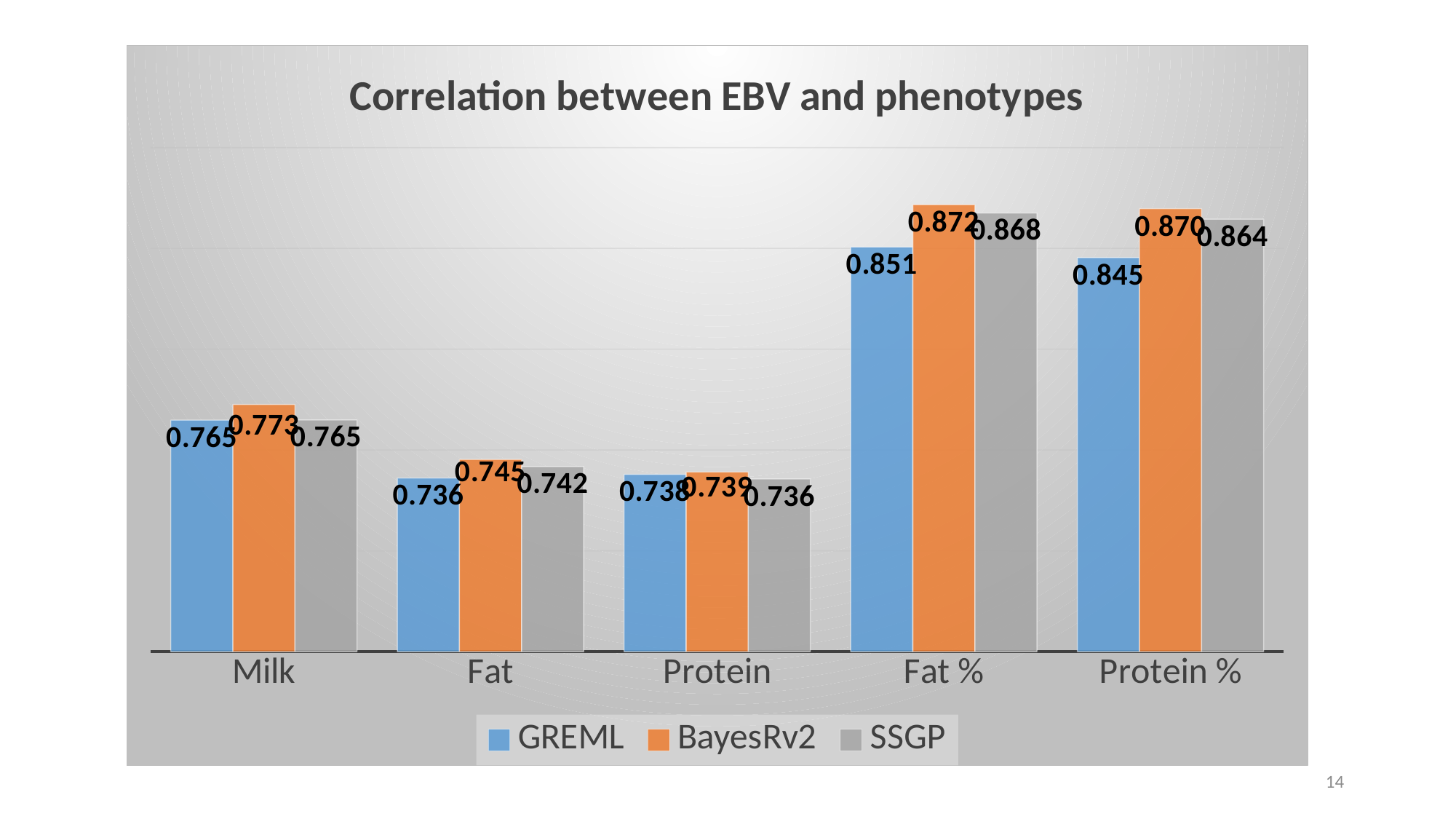
Which category has the lowest GREML value? Fat Which is larger for Protein %: the GREML value or the BayesRv2 value? BayesRv2 What is the GREML value for Fat %? 0.851 What is the BayesRv2 value for Fat? 0.745 What is the difference between the BayesRv2 and GREML values for Fat %? 0.021 Which category has the highest BayesRv2 value? Fat % What is the BayesRv2 value for Milk? 0.773 How many categories are shown on the x axis? 5 What type of chart is shown on the slide? Bar chart How many series does the legend list? 3 What is the SSGP value for Protein %? 0.864 What is the difference between the SSGP value for Protein % and the SSGP value for Milk? 0.099